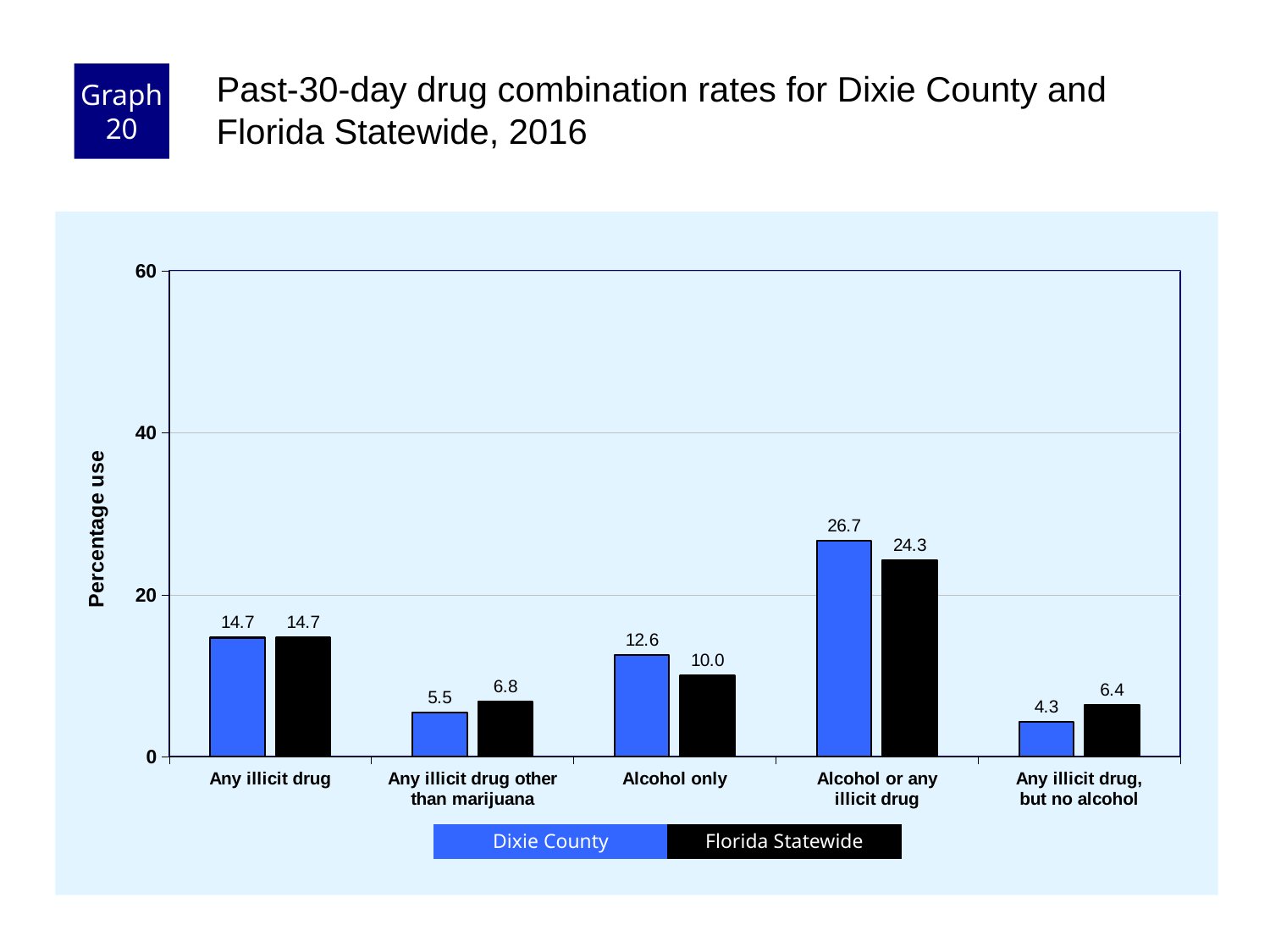
What is the Florida Statewide value for Any illicit drug, but no alcohol? 6.4 Which category has the highest Dixie County value? Alcohol or any illicit drug Is the Florida Statewide value for Alcohol or any illicit drug greater or less than 20? greater How many categories are shown on the x axis? 5 What kind of chart is shown? bar chart What is the Dixie County value for Any illicit drug other than marijuana? 5.5 What is the difference between the Dixie County and Florida Statewide values for Alcohol or any illicit drug? 2.4 Which is larger for Alcohol only: Dixie County or Florida Statewide? Dixie County How many series does the legend list? 2 Which category has the lowest Florida Statewide value? Any illicit drug, but no alcohol What is the label of the y axis? Percentage use What is the Dixie County value for Alcohol only? 12.6